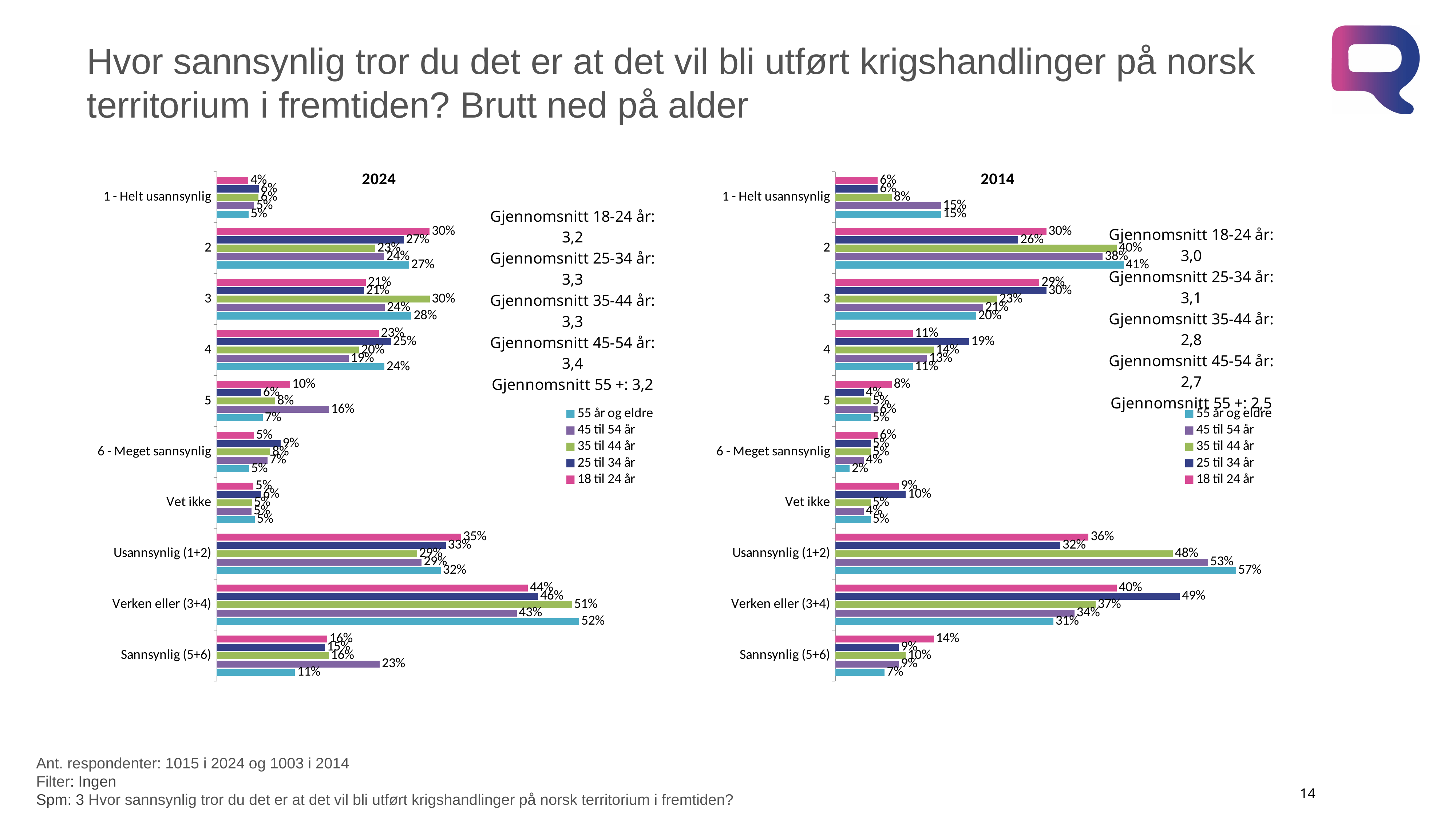
In the 2014 chart, what is the value for 25 til 34 år in the Verken eller (3+4) category? 49% How many categories are shown on the vertical axis of the 2014 chart? 10 In the 2024 chart, what is the value for 45 til 54 år in the Sannsynlig (5+6) category? 23% In the 2014 chart, which age group has the highest value in the Usannsynlig (1+2) category? 55 år og eldre In the 2014 chart, what is the difference between the 55 år og eldre and 18 til 24 år values in the Usannsynlig (1+2) category? 21 percentage points In the 2024 chart, which is larger in the Verken eller (3+4) category: 35 til 44 år or 45 til 54 år? 35 til 44 år In the 2014 chart, what is the Gjennomsnitt (average) shown for 55 +? 2,5 In the 2024 chart, what is the value for 55 år og eldre in the Verken eller (3+4) category? 52% In the 2014 chart, what is the value for 55 år og eldre in the Usannsynlig (1+2) category? 57% How many series does the legend of the 2024 chart list? 5 In the 2024 chart, which age group has the lowest value in the Sannsynlig (5+6) category? 55 år og eldre What kind of chart is the 2014 chart? Bar chart